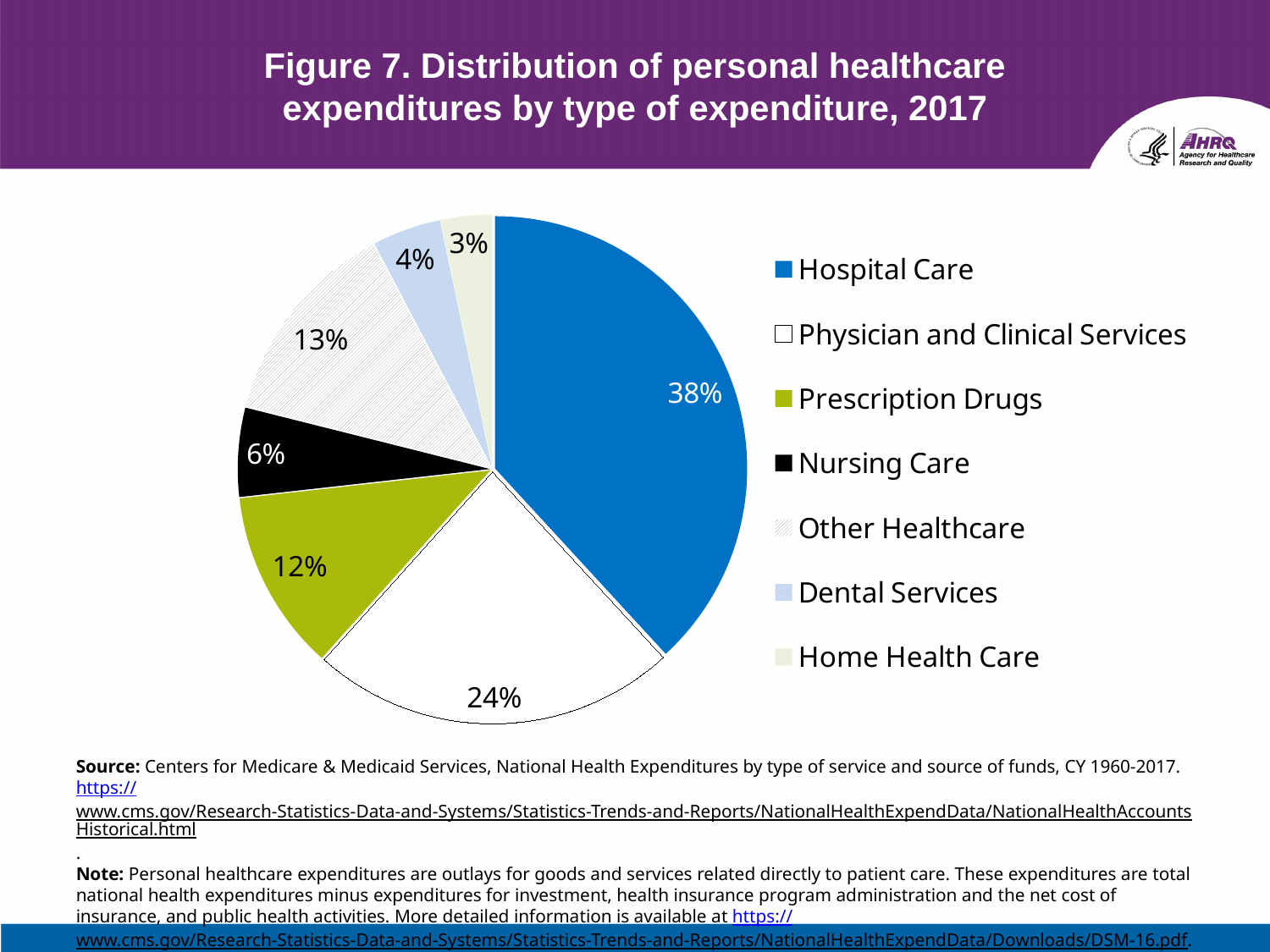
What share of personal healthcare expenditures is Nursing Care? 6% What is the difference in percentage points between Hospital Care and Physician and Clinical Services? 14 Which type of expenditure has the smallest share of the pie? Home Health Care What share of personal healthcare expenditures is Prescription Drugs? 12% What share of personal healthcare expenditures is Other Healthcare? 13% What share of personal healthcare expenditures is Dental Services? 4% Which has a larger share, Other Healthcare or Prescription Drugs? Other Healthcare What type of chart is shown on the slide? Pie chart What share of personal healthcare expenditures is Hospital Care? 38% Which type of expenditure has the largest share of the pie? Hospital Care What share of personal healthcare expenditures is Physician and Clinical Services? 24% How many types of expenditure are listed in the legend? 7